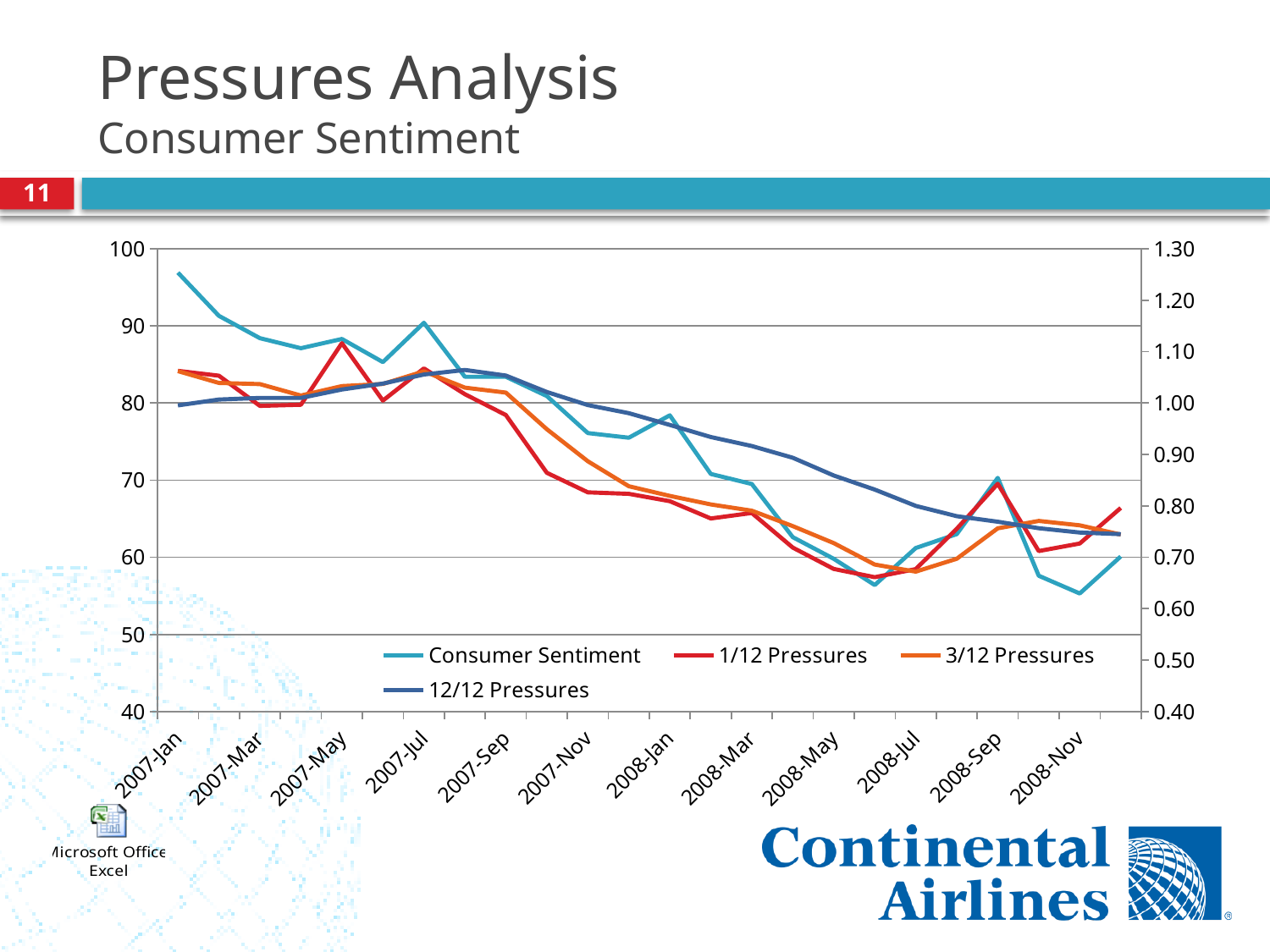
Does the Consumer Sentiment line generally rise or fall from 2007-Jan to 2008-Nov? Fall At which labelled month is the Consumer Sentiment line at its highest? 2007-Jan What kind of chart is shown on the slide? Line chart Which series are listed in the chart legend? Consumer Sentiment, 1/12 Pressures, 3/12 Pressures, 12/12 Pressures Is the Consumer Sentiment value at 2008-Nov greater or less than 60? less Is the 12/12 Pressures value at 2008-Nov greater or less than 0.80 on the right axis? less How many series does the chart legend list? 4 Does the 12/12 Pressures line rise or fall from 2007-Sep to 2008-Nov? Fall What colour is the 1/12 Pressures line? Red Which is larger for Consumer Sentiment: the value at 2007-Jan or the value at 2008-Nov? 2007-Jan Is the 1/12 Pressures value at 2007-May greater or less than 1.00 on the right axis? greater